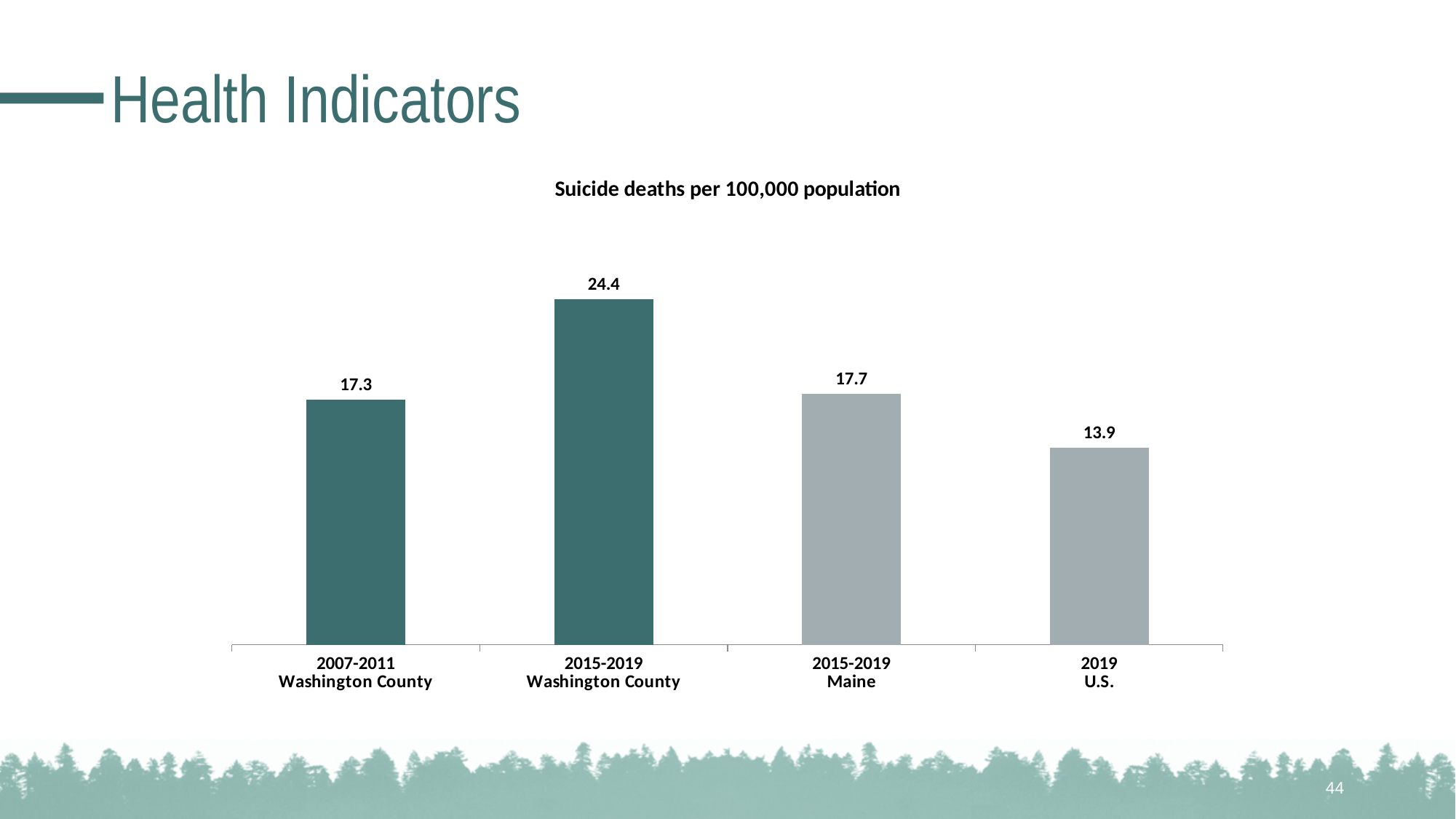
Which category has the highest value? 2015-2019 Washington County How many bars are shown in the chart? 4 What is the value for 2015-2019 Washington County? 24.4 What is the difference between the 2015-2019 Maine value and the 2019 U.S. value? 3.8 What is the value for 2019 U.S.? 13.9 Which category has the lowest value? 2019 U.S. What is the value for 2007-2011 Washington County? 17.3 What kind of chart is shown on the slide? Bar chart What is the difference between the 2015-2019 Washington County value and the 2007-2011 Washington County value? 7.1 What is the value for 2015-2019 Maine? 17.7 What is the title of the chart? Suicide deaths per 100,000 population Which is larger, the value for 2015-2019 Washington County or the value for 2015-2019 Maine? 2015-2019 Washington County